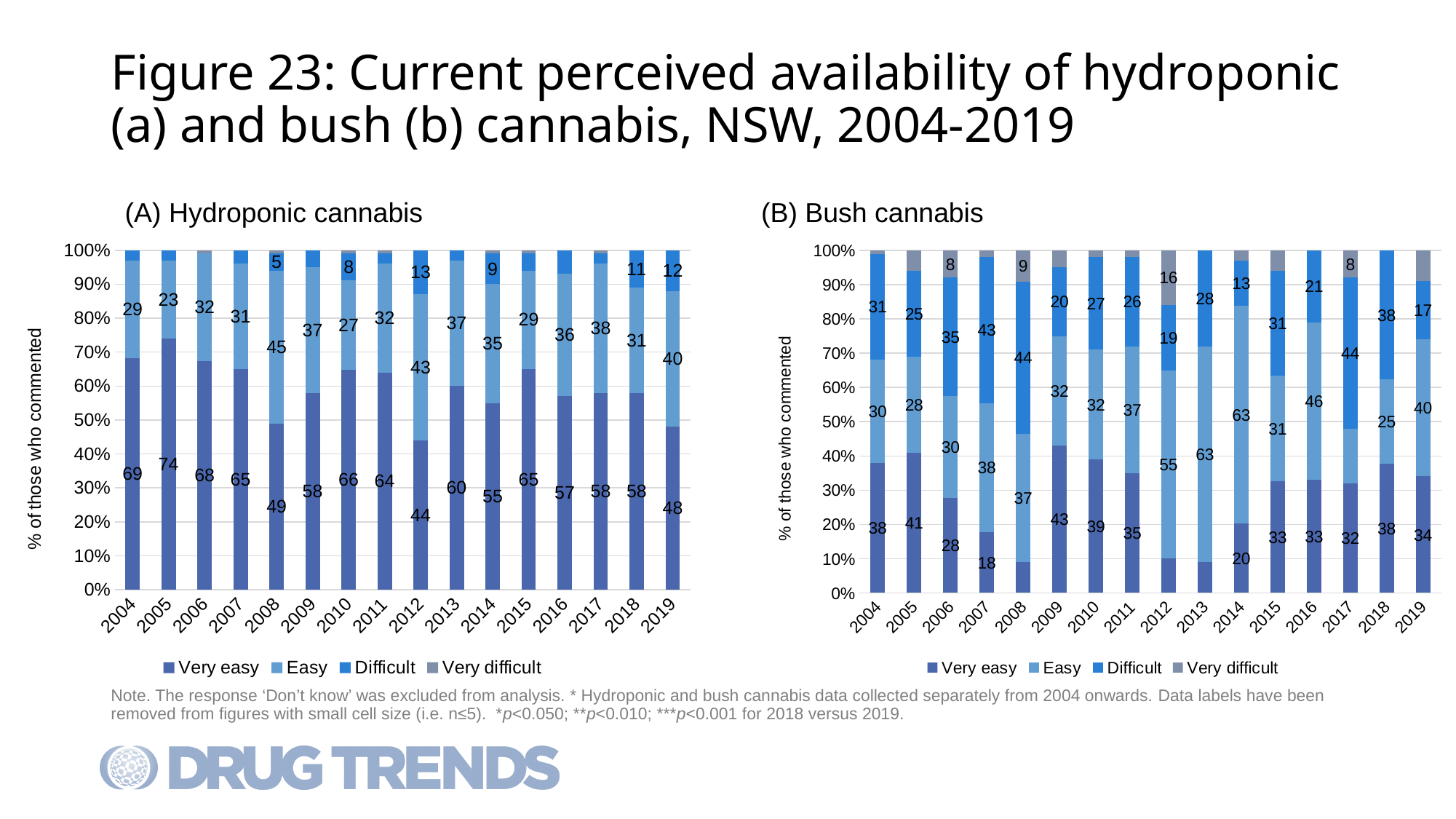
In chart (B) Bush cannabis, what is the 'Difficult' value for 2008? 44 How many series does the legend of chart (A) Hydroponic cannabis list? 4 In chart (A) Hydroponic cannabis, what percentage of respondents said 'Very easy' in 2005? 74 What kind of chart is chart (A) Hydroponic cannabis? Stacked bar chart In chart (A) Hydroponic cannabis, what is the difference between the 'Very easy' values for 2004 and 2019? 21 In chart (B) Bush cannabis, which is larger, the 'Very easy' value for 2009 or for 2014? 2009 In chart (B) Bush cannabis, what is the 'Easy' value for 2013? 63 In chart (A) Hydroponic cannabis, which year has the highest 'Very easy' value? 2005 How many years are shown on the x axis of chart (B) Bush cannabis? 16 In chart (A) Hydroponic cannabis, what is the 'Easy' value for 2008? 45 In chart (B) Bush cannabis, what is the 'Very difficult' value for 2012? 16 In chart (A) Hydroponic cannabis, which year has the lowest 'Very easy' value? 2012